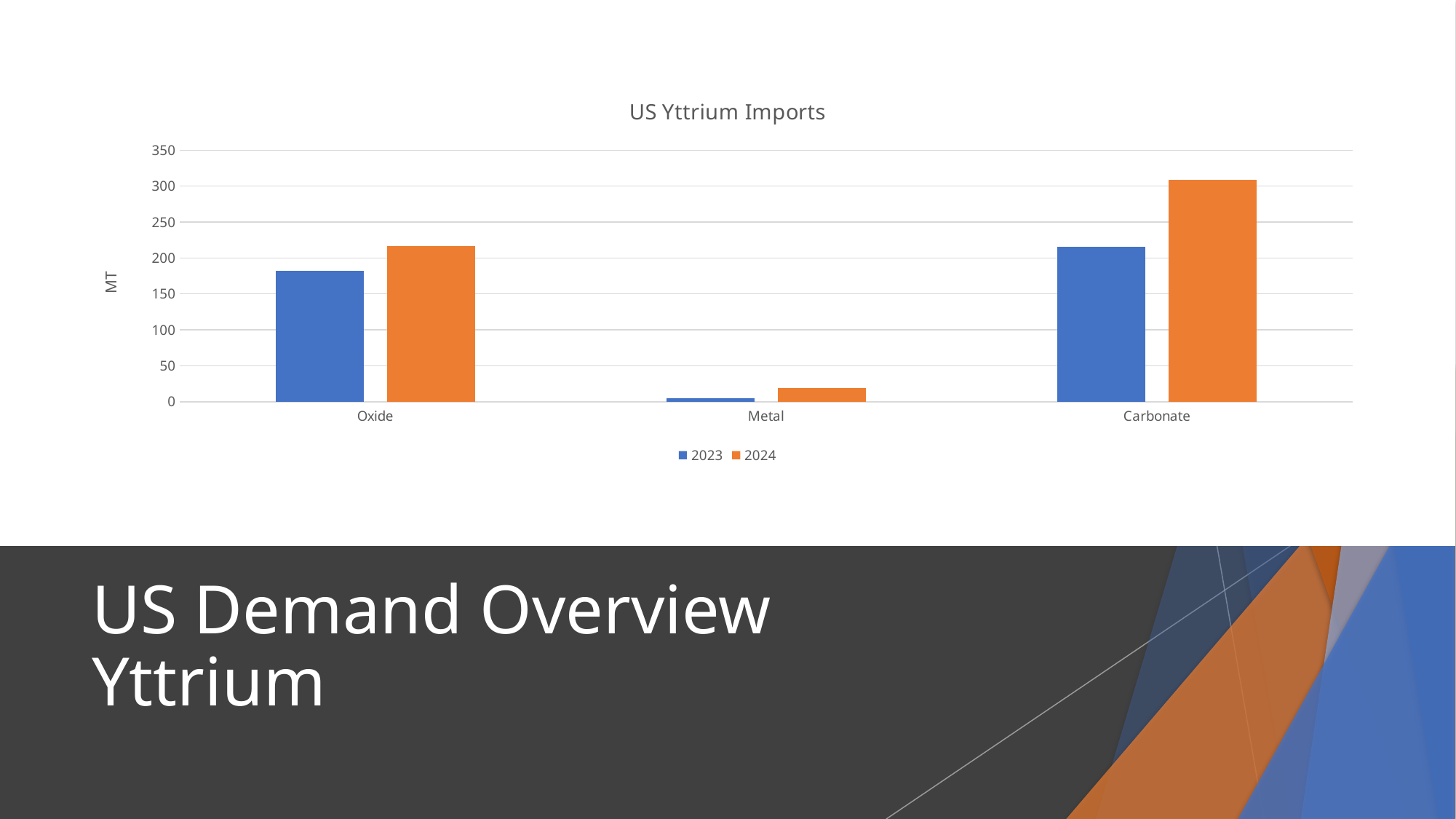
Which category has the highest 2024 value? Carbonate Is the 2024 value for Carbonate greater or less than 300? greater What kind of chart is shown on the slide? bar chart What is the title of the chart? US Yttrium Imports How many categories are shown on the x axis? 3 Is the 2023 value for Oxide greater or less than 200? less Which category has the lowest 2023 value? Metal Is the 2024 value for Metal greater or less than 50? less Which is larger, the 2024 value for Oxide or the 2024 value for Metal? Oxide For Carbonate, which year has the larger value, 2023 or 2024? 2024 How many series does the legend list? 2 What is the label on the vertical axis? MT